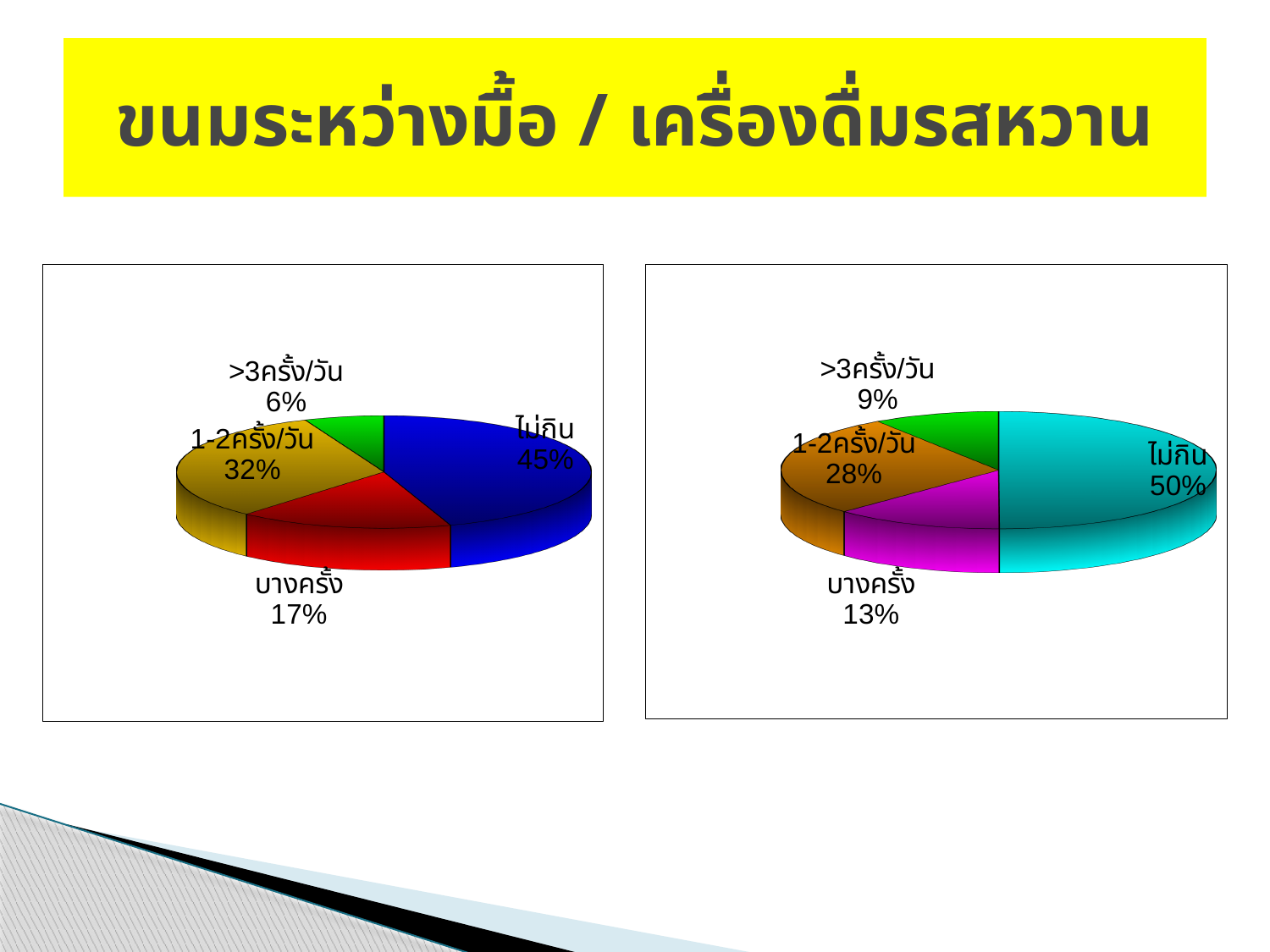
Which is larger in the right pie chart: the share for 1-2ครั้ง/วัน or the share for บางครั้ง? 1-2ครั้ง/วัน In the left pie chart, what is the difference between the shares for 1-2ครั้ง/วัน and บางครั้ง? 15% What type of chart is shown on the right side of the slide? Pie chart In the right pie chart, what percentage is shown for 1-2ครั้ง/วัน? 28% In the right pie chart, what percentage is shown for >3ครั้ง/วัน? 9% In the right pie chart, which category has the smallest share? >3ครั้ง/วัน How many slices does the left pie chart have? 4 In the left pie chart, which category has the largest share? ไม่กิน What is the title of the slide? ขนมระหว่างมื้อ / เครื่องดื่มรสหวาน In the right pie chart, what is the difference between the shares for ไม่กิน and บางครั้ง? 37% In the left pie chart, what percentage is shown for บางครั้ง? 17% In the left pie chart, what percentage is shown for ไม่กิน? 45%